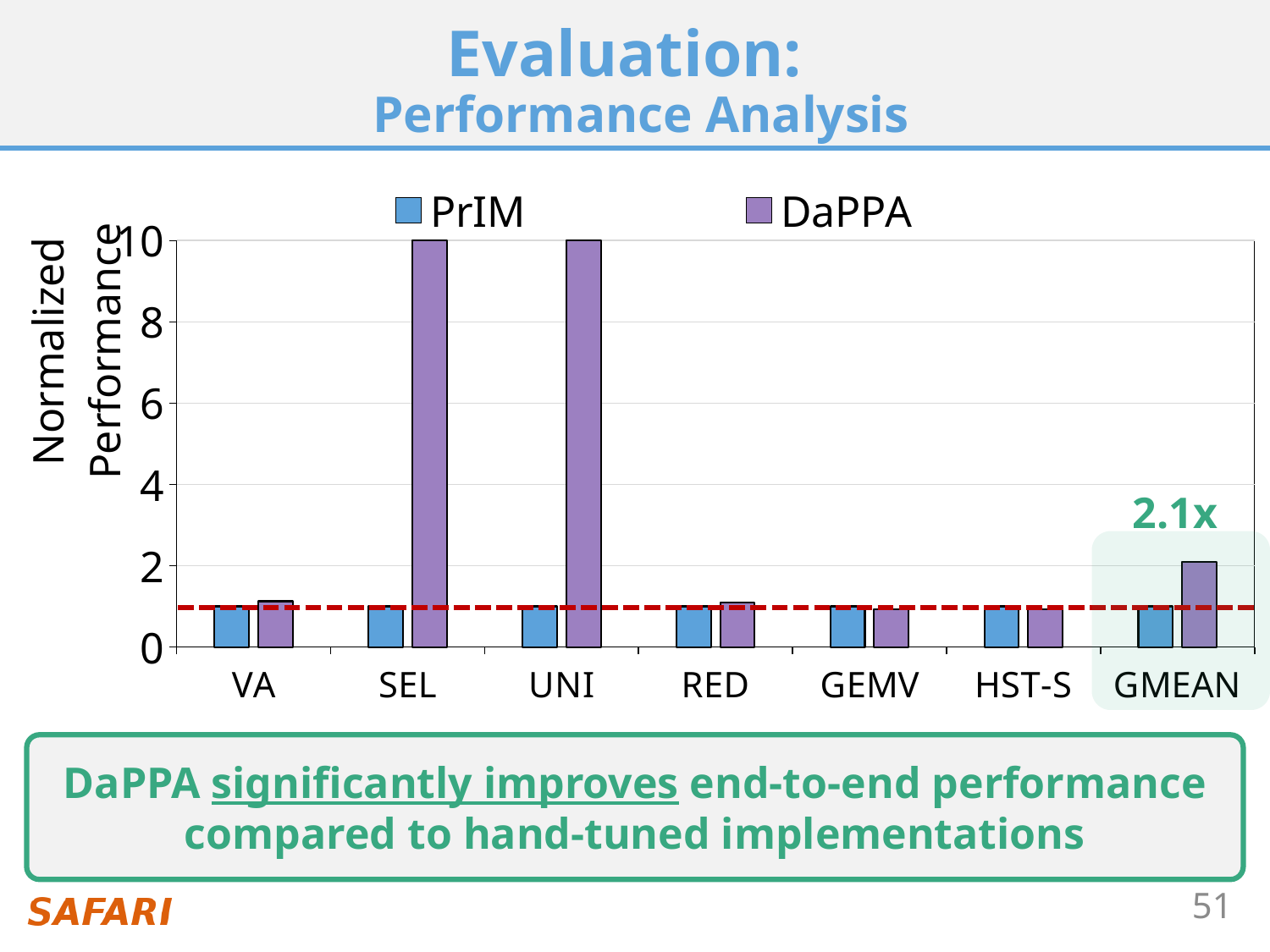
What value is labelled above the GMEAN bars for DaPPA? 2.1x Is the DaPPA value for GMEAN greater or less than 4? less What are the two series named in the legend? PrIM and DaPPA Is the PrIM value for RED greater or less than 2? less What is the label on the y axis? Normalized Performance Which is larger, the DaPPA value for SEL or the DaPPA value for RED? SEL Is the DaPPA value for VA greater or less than 2? less What kind of chart is shown on the slide? bar chart How many categories are shown on the x axis? 7 How many series does the legend list? 2 Which is larger, the DaPPA value for UNI or the DaPPA value for GMEAN? UNI